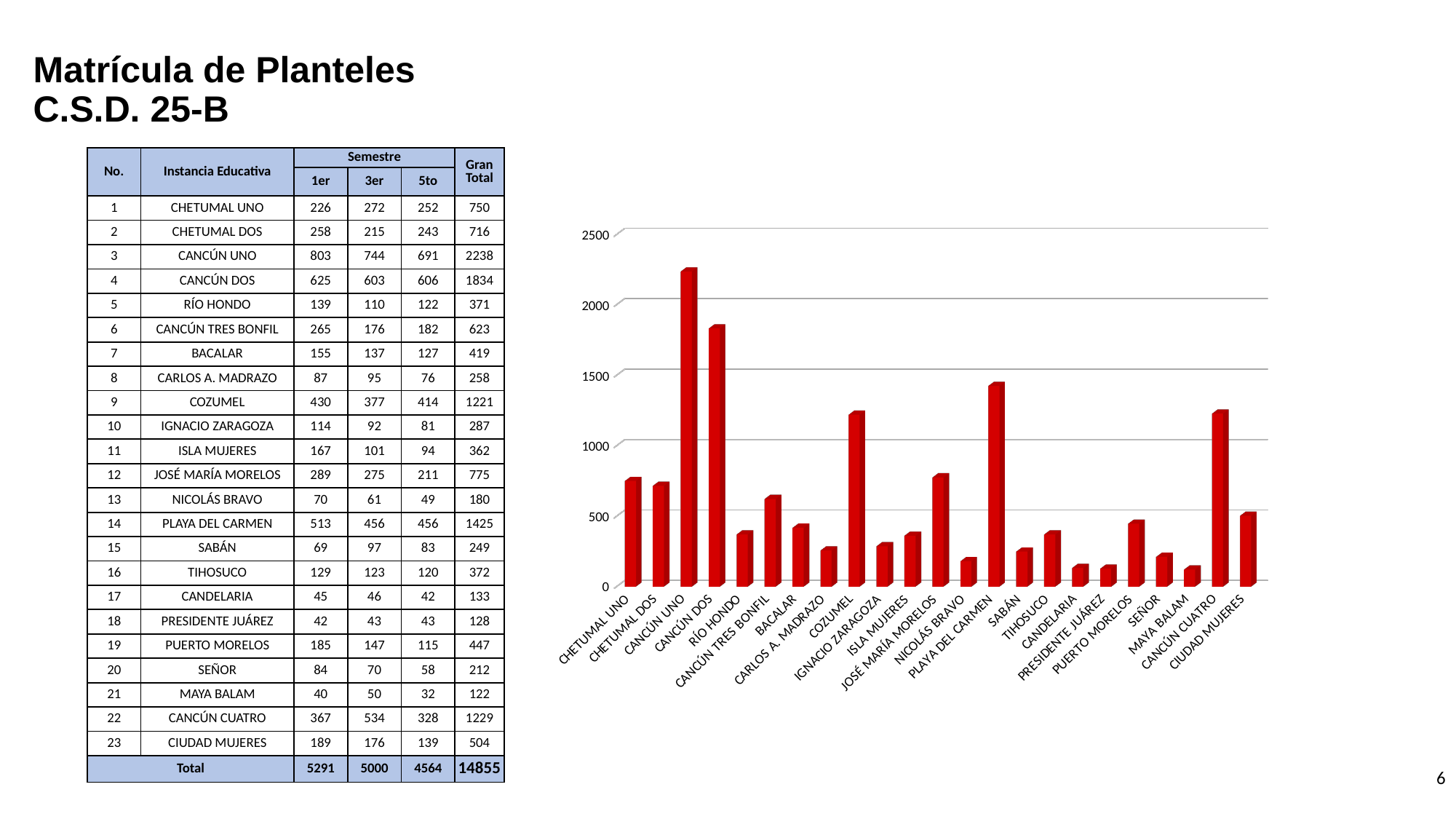
Is the bar for COZUMEL greater or less than 1000? greater What is the difference between the Gran Total for CANCÚN UNO and CANCÚN DOS? 404 Which plantel has the tallest bar on the chart? CANCÚN UNO What is the Gran Total value plotted for CANCÚN UNO? 2238 Is the bar for RÍO HONDO greater or less than 500? less What colour are the bars in the chart? red Which bar is taller, PLAYA DEL CARMEN or COZUMEL? PLAYA DEL CARMEN Is the bar for CANCÚN DOS greater or less than 1500? greater What kind of chart is shown on the slide? bar chart How many planteles (categories) are plotted on the chart? 23 Which bar is taller, CANCÚN UNO or CANCÚN DOS? CANCÚN UNO